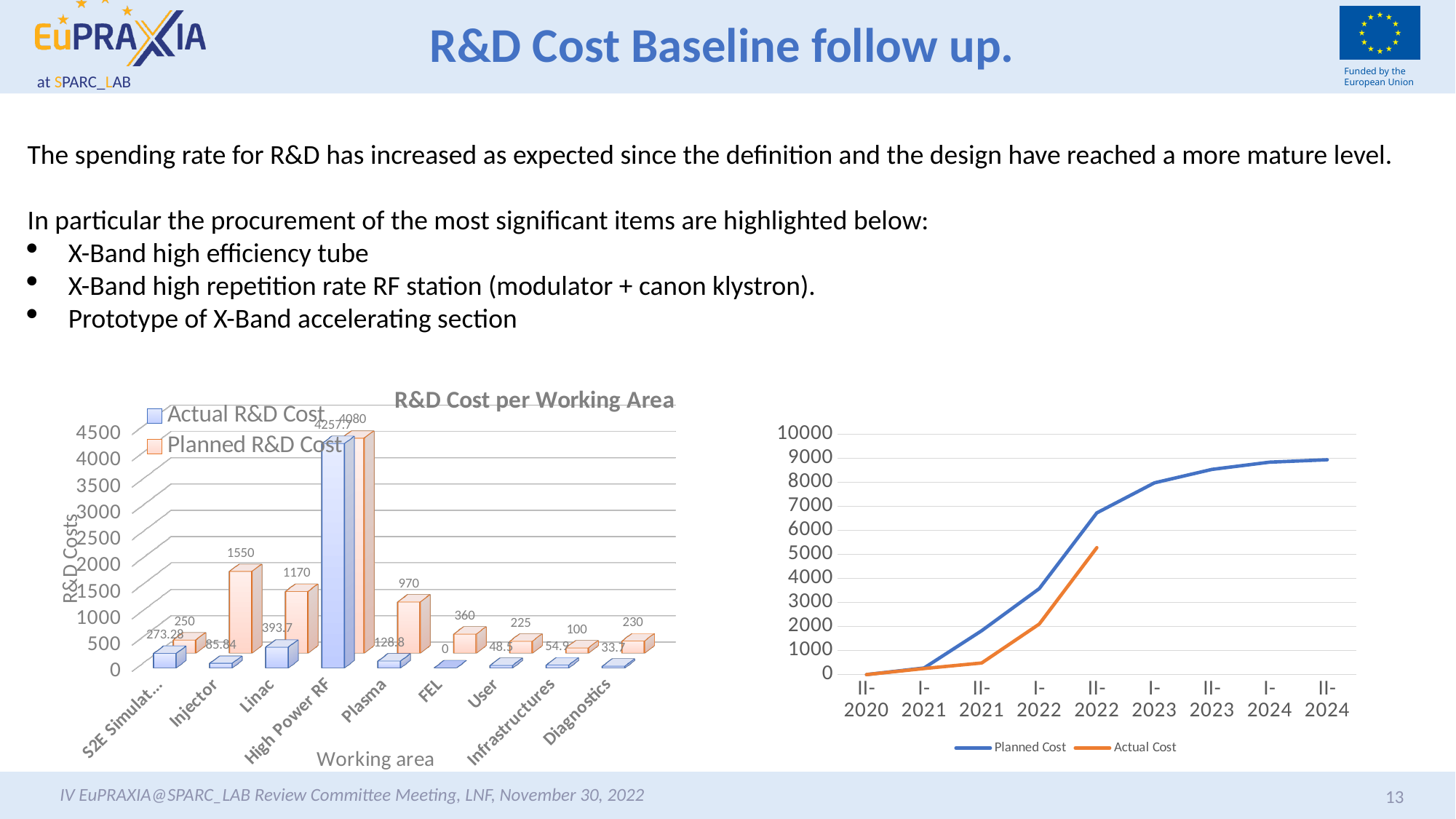
In the line chart on the right, does the Planned Cost rise or fall from II-2020 to II-2024? rise In the 'R&D Cost per Working Area' chart, is the Actual R&D Cost for S2E Simulat... larger or smaller than its Planned R&D Cost? larger In the 'R&D Cost per Working Area' chart, what is the difference between the Planned and Actual R&D Cost for Plasma? 841.2 In the 'R&D Cost per Working Area' chart, what is the Actual R&D Cost for Linac? 393.7 What kind of chart is the chart on the right of the slide? line chart In the 'R&D Cost per Working Area' chart, which working area has the highest Actual R&D Cost? High Power RF In the 'R&D Cost per Working Area' chart, which working area has the lowest Actual R&D Cost? FEL How many working areas are shown on the x axis of the 'R&D Cost per Working Area' chart? 9 In the 'R&D Cost per Working Area' chart, what is the Planned R&D Cost for High Power RF? 4080 In the 'R&D Cost per Working Area' chart, what is the Planned R&D Cost for Injector? 1550 How many series does the legend of the 'R&D Cost per Working Area' chart list? 2 In the line chart on the right, is the Planned Cost at II-2024 greater or less than 8000? greater